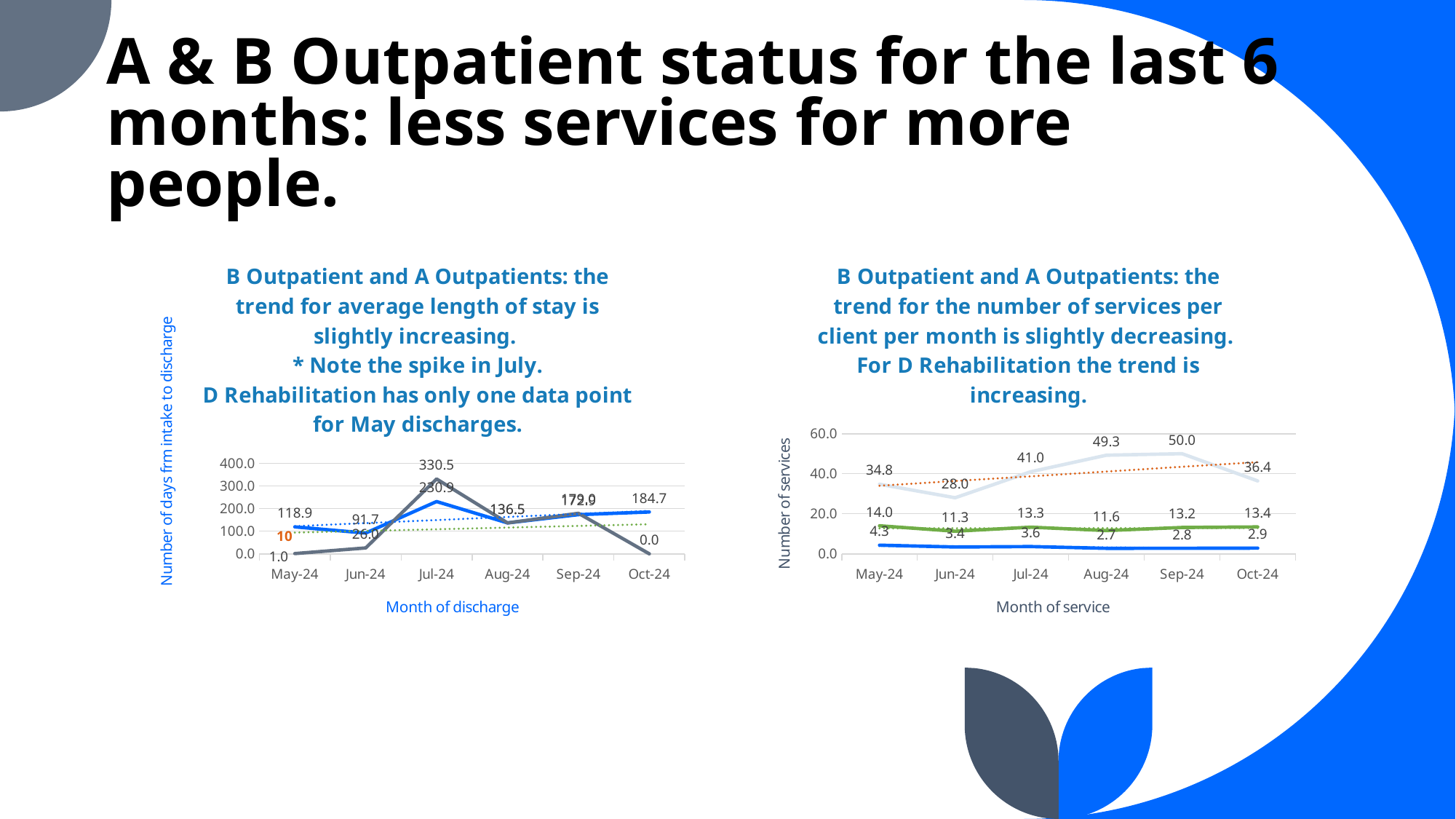
How many months are shown on the x axis of the right chart? 6 On the right chart, what is the highest data label shown, and in which month does it occur? 50.0 in Sep-24 On the right chart, what is the lowest data label shown, and in which month does it occur? 2.7 in Aug-24 What is the x-axis title of the right chart? Month of service How many months are shown on the x axis of the left chart? 6 On the right chart, what is the value of the topmost line in Jul-24? 41.0 What type of chart is the right chart on the slide? line chart On the right chart, is the topmost line's value in Sep-24 greater or less than 40.0? greater On the right chart, what is the difference between the topmost line's values in Sep-24 (50.0) and Oct-24 (36.4)? 13.6 What type of chart is the left chart on the slide? line chart On the left chart, what is the highest data label shown, and in which month does it occur? 330.5 in Jul-24 What is the y-axis title of the left chart? Number of days frm intake to discharge